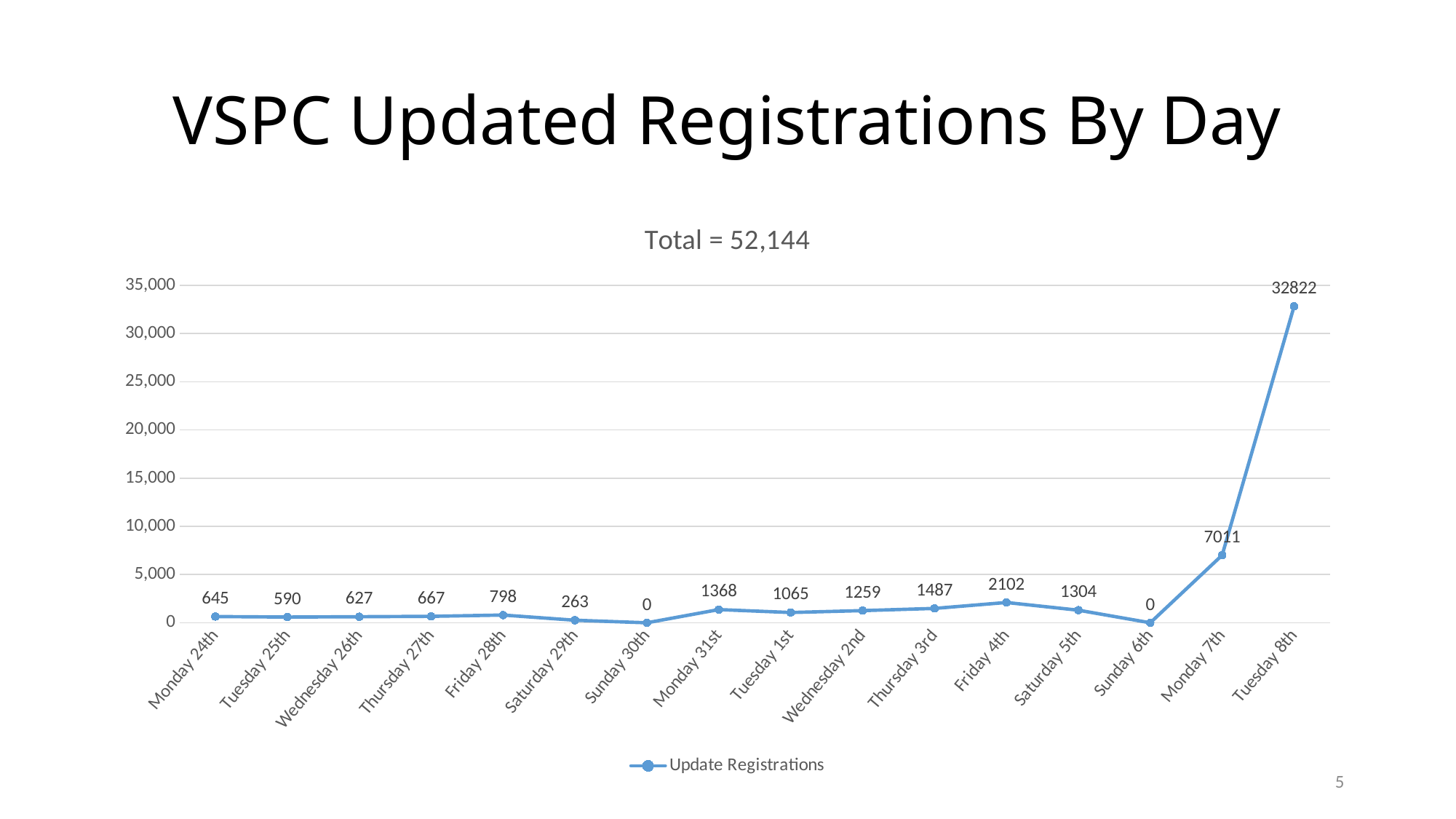
What is the name of the series in the legend? Update Registrations What is the value for Saturday 29th? 263 What is the chart's title? Total = 52,144 Which is larger, the value for Monday 31st or the value for Tuesday 1st? Monday 31st How many series does the legend list? 1 Is the value for Tuesday 8th greater or less than 30,000? greater Which day has the highest value? Tuesday 8th What is the value for Monday 7th? 7011 What is the value for Friday 4th? 2102 What is the difference between the values for Tuesday 8th and Monday 7th? 25811 How many days are plotted on the x axis? 16 What kind of chart is shown? line chart